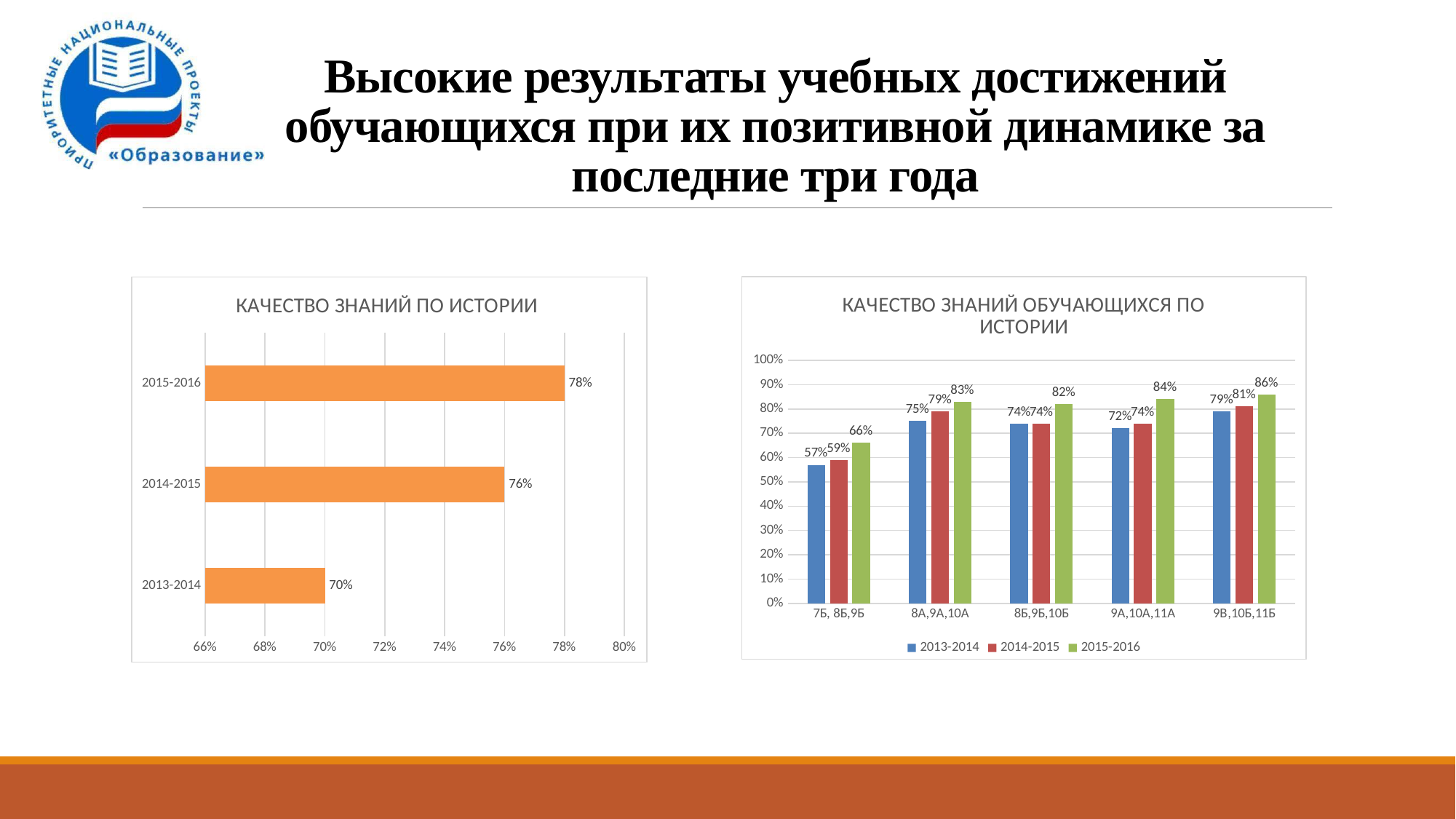
In the left chart 'КАЧЕСТВО ЗНАНИЙ ПО ИСТОРИИ', which year has the lowest value? 2013-2014 In the right chart 'КАЧЕСТВО ЗНАНИЙ ОБУЧАЮЩИХСЯ ПО ИСТОРИИ', which group has the highest 2015-2016 value? 9В,10Б,11Б What type of chart is the left chart 'КАЧЕСТВО ЗНАНИЙ ПО ИСТОРИИ'? Bar chart In the right chart 'КАЧЕСТВО ЗНАНИЙ ОБУЧАЮЩИХСЯ ПО ИСТОРИИ', how many series does the legend list? 3 In the right chart 'КАЧЕСТВО ЗНАНИЙ ОБУЧАЮЩИХСЯ ПО ИСТОРИИ', which is larger for 8Б,9Б,10Б: the 2014-2015 value or the 2015-2016 value? 2015-2016 In the right chart 'КАЧЕСТВО ЗНАНИЙ ОБУЧАЮЩИХСЯ ПО ИСТОРИИ', what is the 2013-2014 value for 7Б, 8Б,9Б? 57% In the right chart 'КАЧЕСТВО ЗНАНИЙ ОБУЧАЮЩИХСЯ ПО ИСТОРИИ', what is the 2015-2016 value for 9А,10А,11А? 84% In the right chart 'КАЧЕСТВО ЗНАНИЙ ОБУЧАЮЩИХСЯ ПО ИСТОРИИ', what is the difference between the 2015-2016 and 2013-2014 values for 8А,9А,10А? 8% In the left chart 'КАЧЕСТВО ЗНАНИЙ ПО ИСТОРИИ', what is the value for 2014-2015? 76% In the left chart 'КАЧЕСТВО ЗНАНИЙ ПО ИСТОРИИ', what is the difference between the 2015-2016 and 2013-2014 values? 8% In the left chart 'КАЧЕСТВО ЗНАНИЙ ПО ИСТОРИИ', how many bars are plotted? 3 In the right chart 'КАЧЕСТВО ЗНАНИЙ ОБУЧАЮЩИХСЯ ПО ИСТОРИИ', how many student groups are shown on the x axis? 5